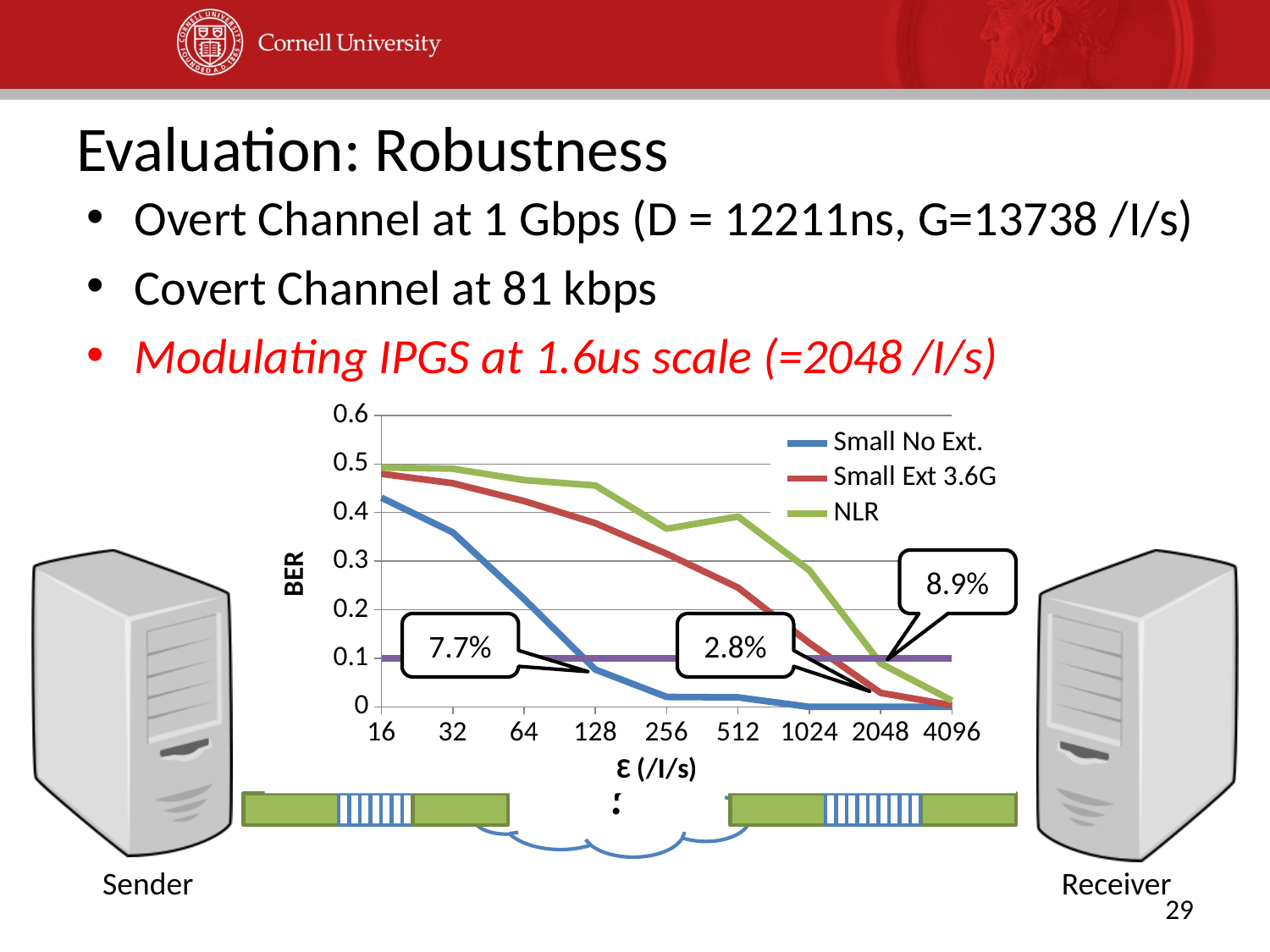
What BER value is called out for the Small No Ext. series at ε = 128? 7.7% How many tick values are shown on the x axis of the chart? 9 Is the BER for NLR at ε = 16 greater or less than 0.4? greater What is the label of the y axis of the chart? BER Is the BER for Small No Ext. at ε = 256 greater or less than 0.1? less What type of chart is shown on the slide? line chart Does BER rise or fall as ε increases along the x axis? fall What BER value is called out for the Small Ext 3.6G series at ε = 2048? 2.8% How many series does the chart legend list? 3 What is the difference between the called-out BER values of NLR and Small Ext 3.6G at ε = 2048? 6.1% At ε = 512, which series has the highest BER? NLR What BER value is called out for the NLR series at ε = 2048? 8.9%